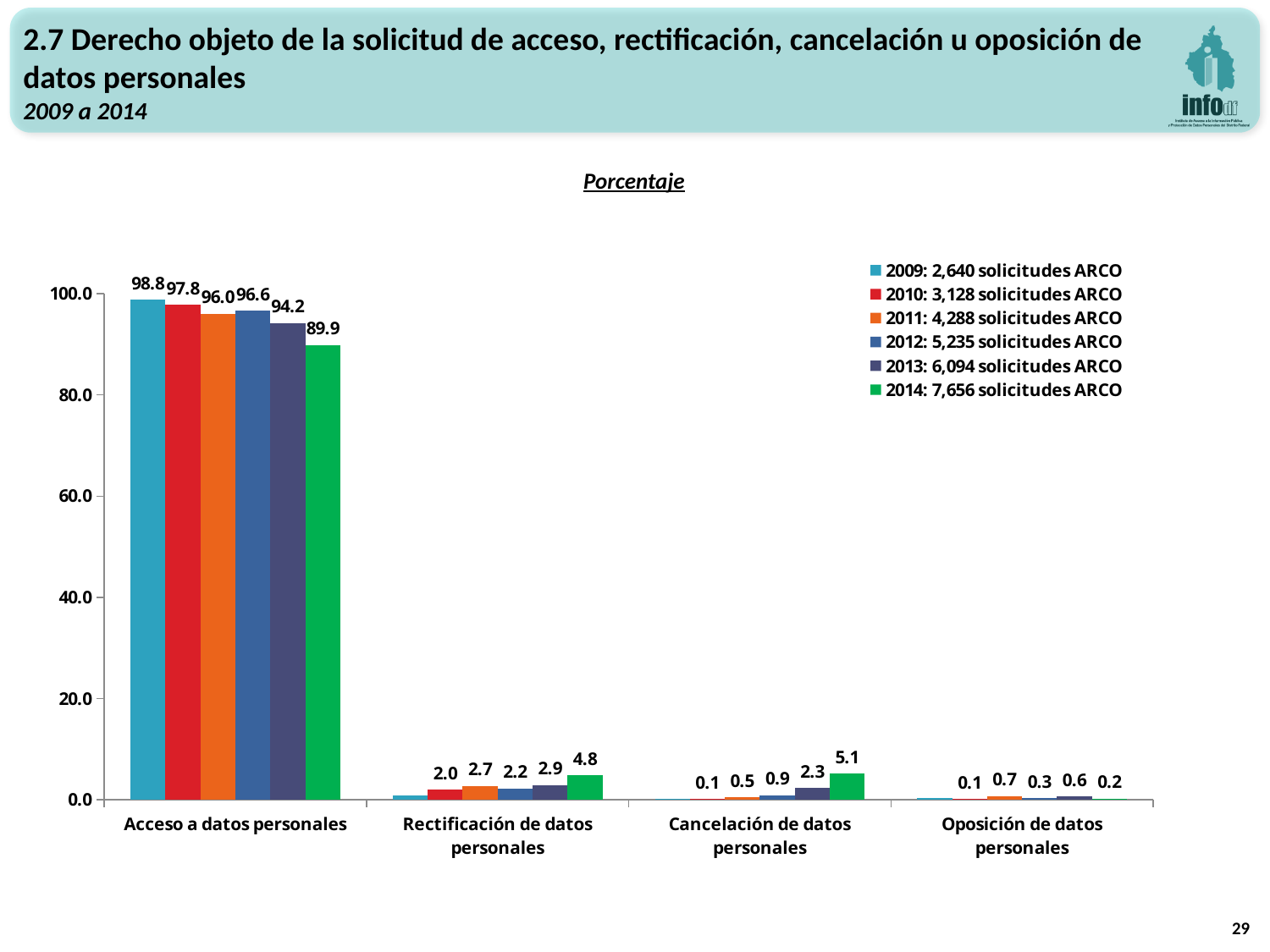
What is the value for 2014 in the 'Acceso a datos personales' category? 89.9 Is the value for 2013 in 'Acceso a datos personales' greater or less than 80.0? greater What is the difference between the 2009 and 2014 values for 'Acceso a datos personales'? 8.9 Which year has the highest value in the 'Acceso a datos personales' category? 2009 What is the value for 2013 in the 'Cancelación de datos personales' category? 2.3 Which year has the lowest value in the 'Acceso a datos personales' category? 2014 What kind of chart is shown on the slide? bar chart What is the value for 2011 in the 'Oposición de datos personales' category? 0.7 How many categories are shown on the x axis? 4 How many series does the legend list? 6 For 2014, which is larger: the value for 'Rectificación de datos personales' or for 'Cancelación de datos personales'? Cancelación de datos personales Do the values for 'Acceso a datos personales' rise or fall from 2009 to 2014? fall